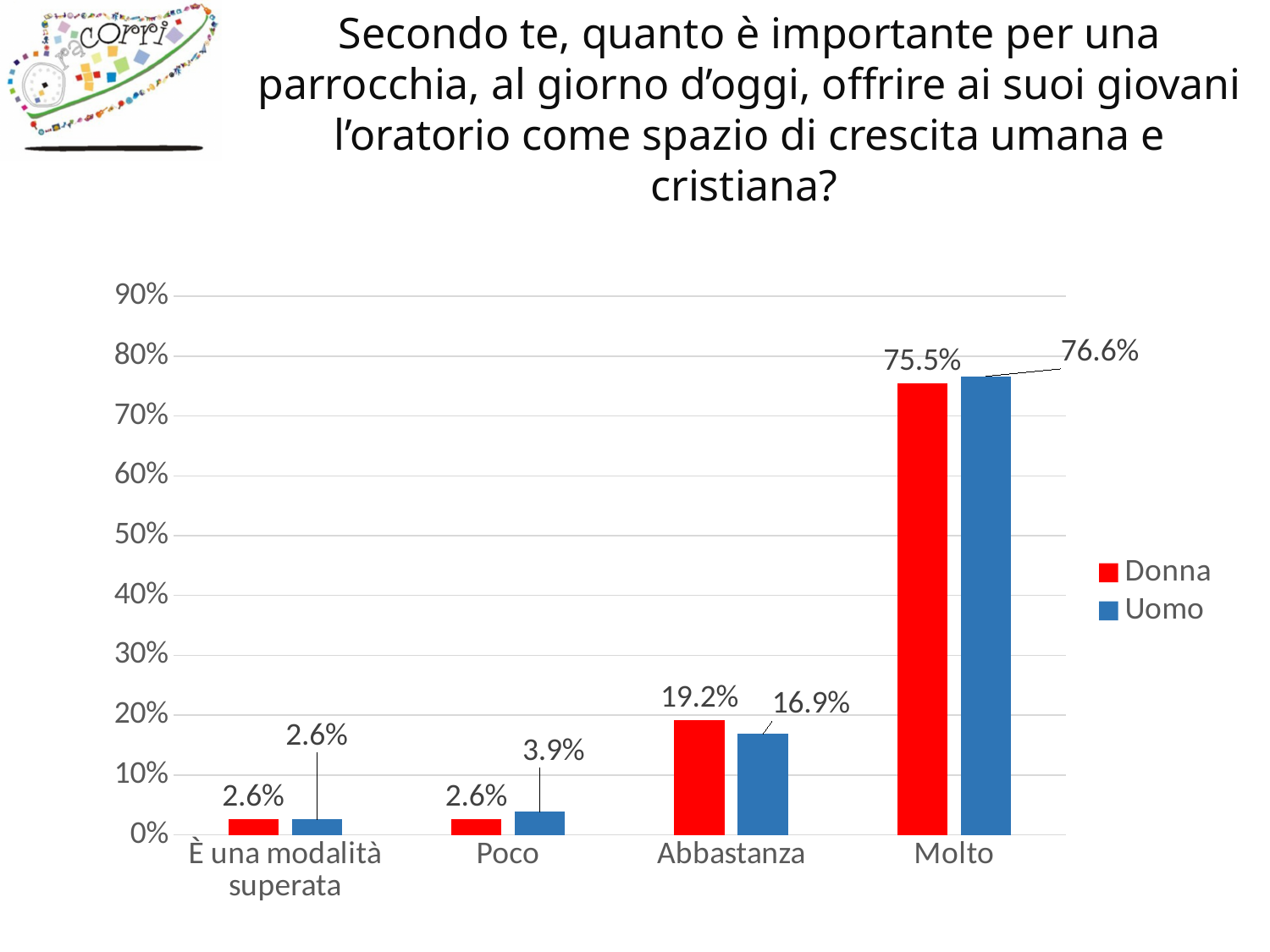
What is the difference between the Uomo and Donna values in the Molto category? 1.1% Which category has the highest value for Uomo? Molto How many series does the legend list? 2 Which colour represents the Uomo series? blue What is the value for Uomo in the Poco category? 3.9% Is the value for Donna in the Molto category greater or less than 70%? greater What is the value for Donna in the Molto category? 75.5% What is the value for Uomo in the Abbastanza category? 16.9% In the Abbastanza category, which series has the larger value, Donna or Uomo? Donna Which category has the lowest value for Donna in the Abbastanza or Molto categories? Abbastanza How many categories are shown on the x axis? 4 What kind of chart is shown on the slide? bar chart